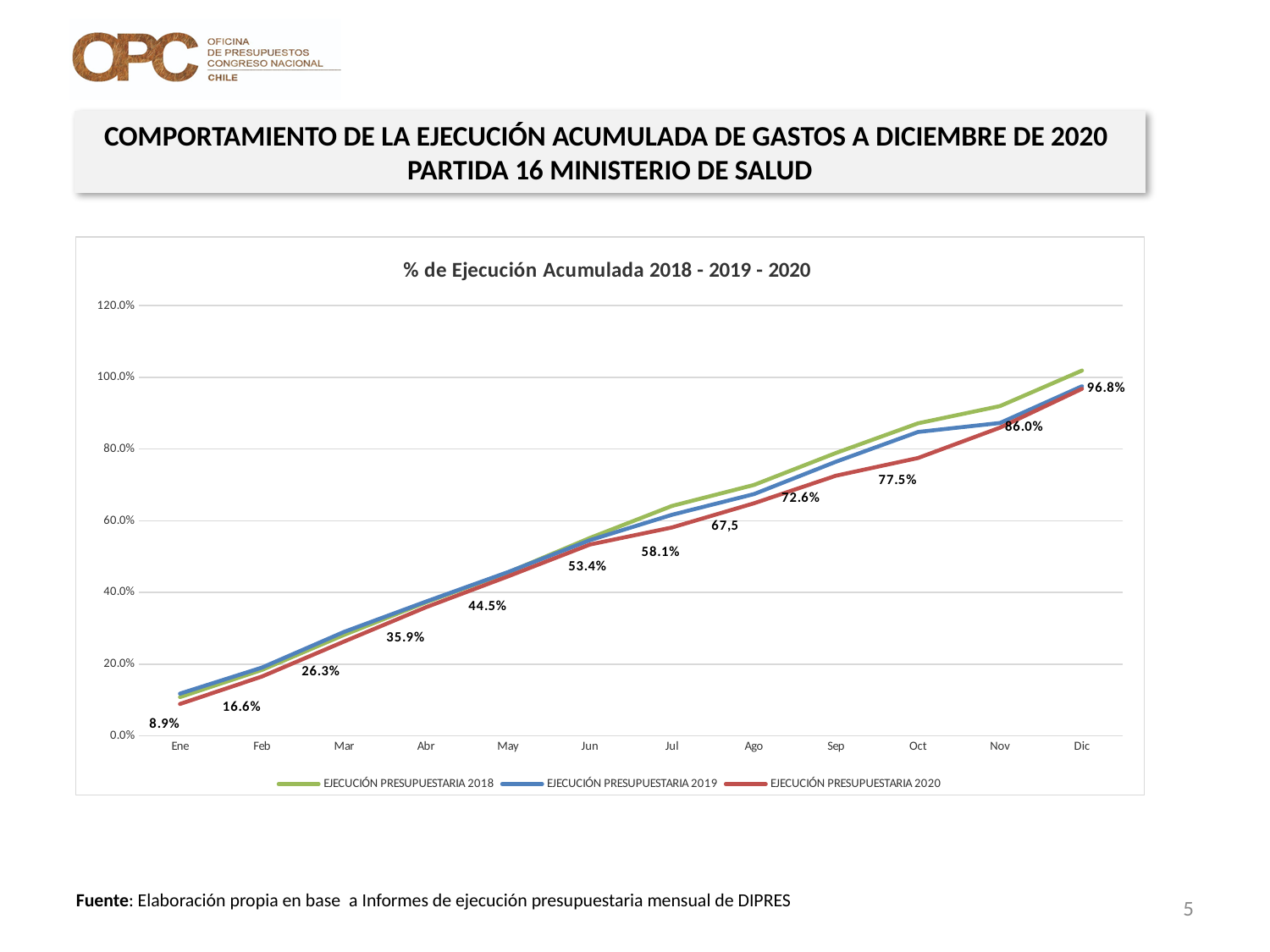
What is the value for EJECUCIÓN PRESUPUESTARIA 2020 in Jun? 53.4% What type of chart is shown on the slide? line chart Do the EJECUCIÓN PRESUPUESTARIA 2020 values rise or fall from Ene to Dic? rise In which month is the EJECUCIÓN PRESUPUESTARIA 2020 value lowest? Ene In which month is the EJECUCIÓN PRESUPUESTARIA 2020 value highest? Dic What is the value for EJECUCIÓN PRESUPUESTARIA 2020 in Ene? 8.9% What is the difference between the EJECUCIÓN PRESUPUESTARIA 2020 values for Dic and Nov? 10.8% What is the value for EJECUCIÓN PRESUPUESTARIA 2020 in Dic? 96.8% Is the value for EJECUCIÓN PRESUPUESTARIA 2018 in Dic greater or less than 100.0%? greater How many months are shown on the x axis? 12 How many series does the legend list? 3 What is the value for EJECUCIÓN PRESUPUESTARIA 2020 in Oct? 77.5%